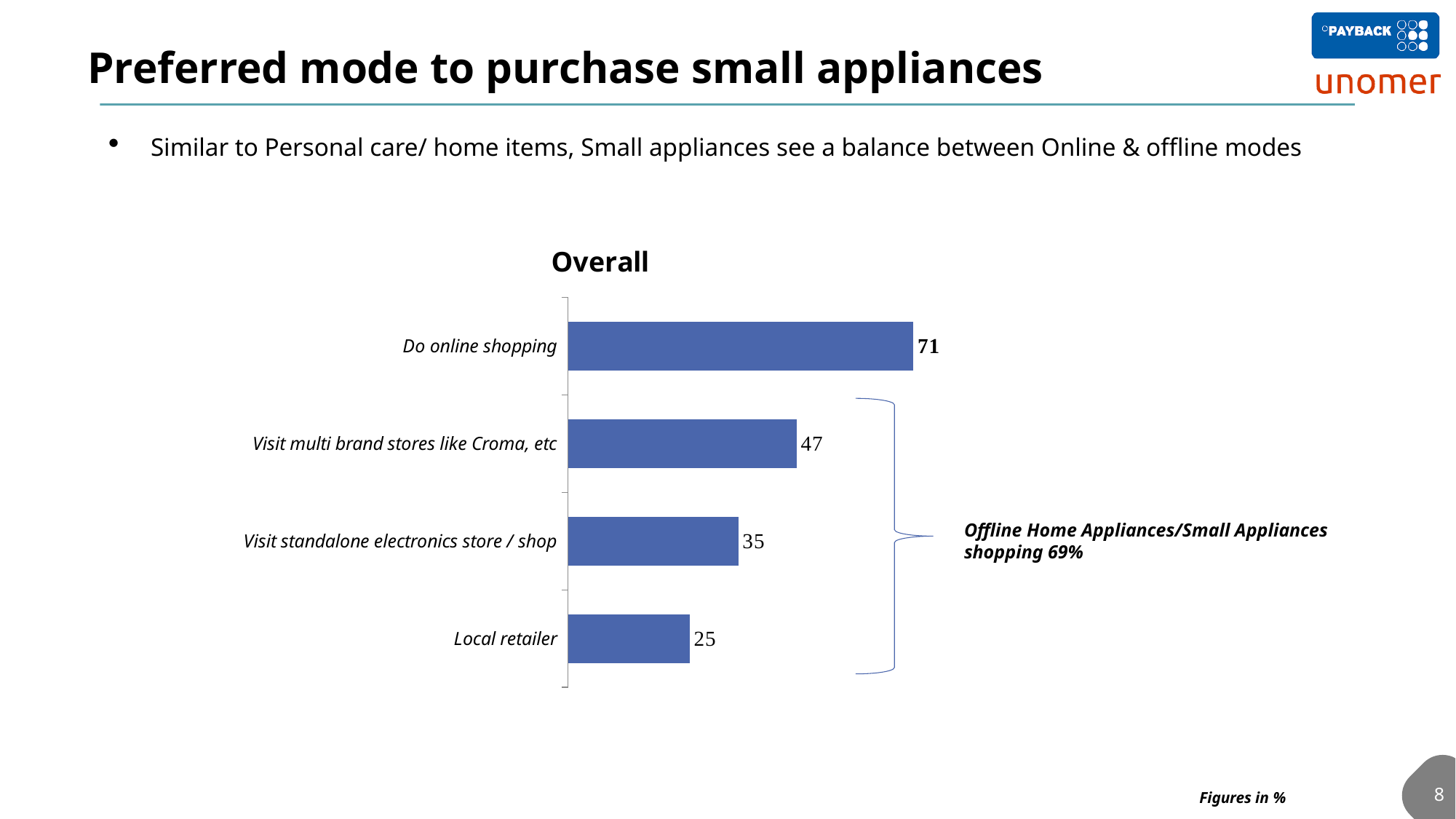
What is the value for Visit standalone electronics store / shop? 35 What is the value for Visit multi brand stores like Croma, etc? 47 What is the title of the chart? Overall What is the value for Do online shopping? 71 Which category has the lowest value? Local retailer How many categories are shown in the chart? 4 What kind of chart is shown on the slide? Bar chart What is the difference between the values for Do online shopping and Local retailer? 46 Which category has the highest value? Do online shopping Which is larger, the value for Visit multi brand stores like Croma, etc or the value for Local retailer? Visit multi brand stores like Croma, etc What is the difference between the values for Visit multi brand stores like Croma, etc and Visit standalone electronics store / shop? 12 What is the value for Local retailer? 25